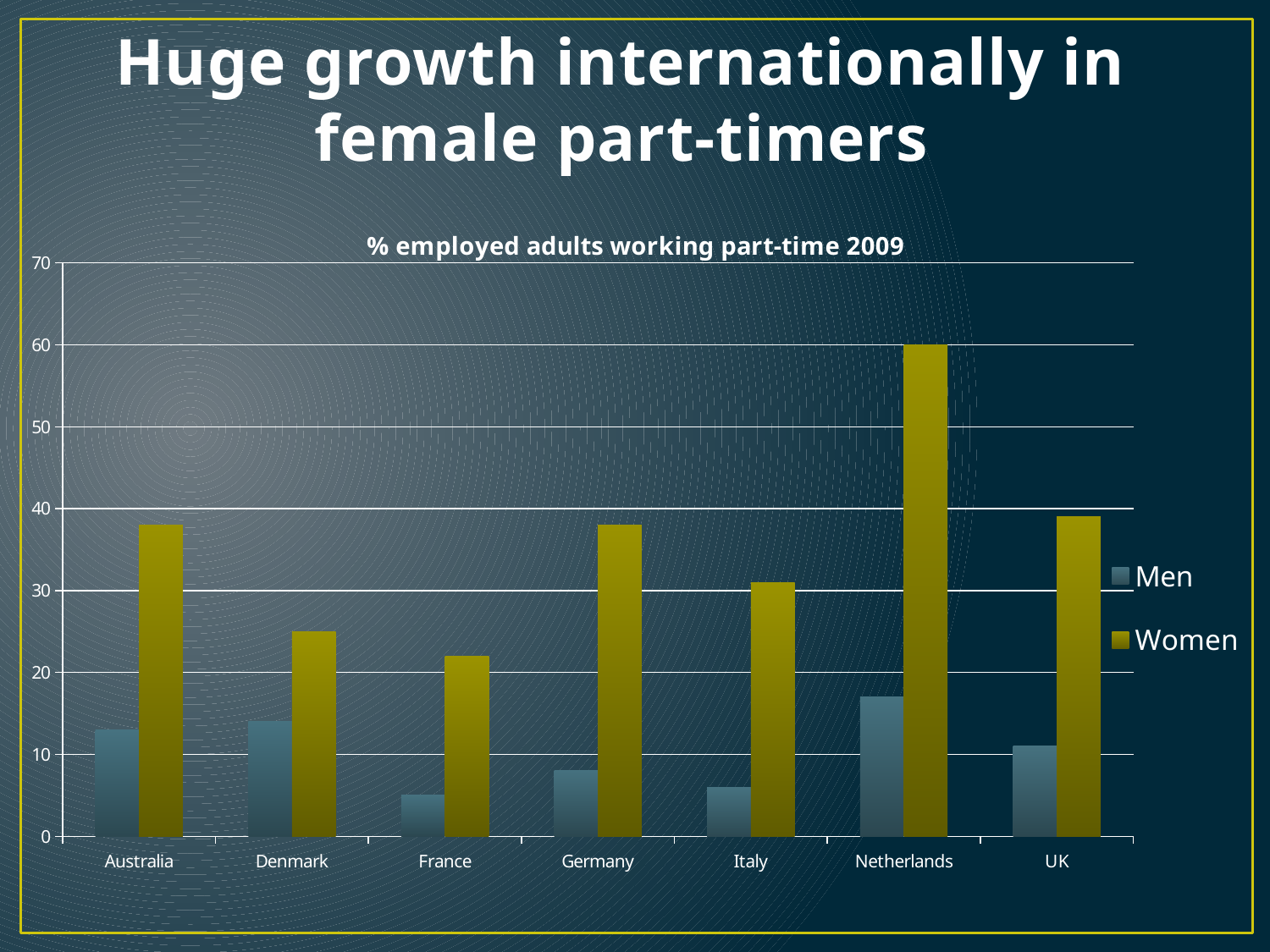
Which country has the lowest value for Women? France Which country has the highest value for Men? Netherlands Which is larger, the Men value for Denmark or the Men value for UK? Denmark Which country has the lowest value for Men? France Is the value for Women in Netherlands greater or less than 50? greater Which is larger, the Women value for Germany or the Women value for Italy? Germany What type of chart is shown on the slide? bar chart How many series does the legend list? 2 Is the value for Men in Germany greater or less than 10? less How many countries are shown on the x axis? 7 Which country has the highest value for Women? Netherlands What is the title of the chart? % employed adults working part-time 2009